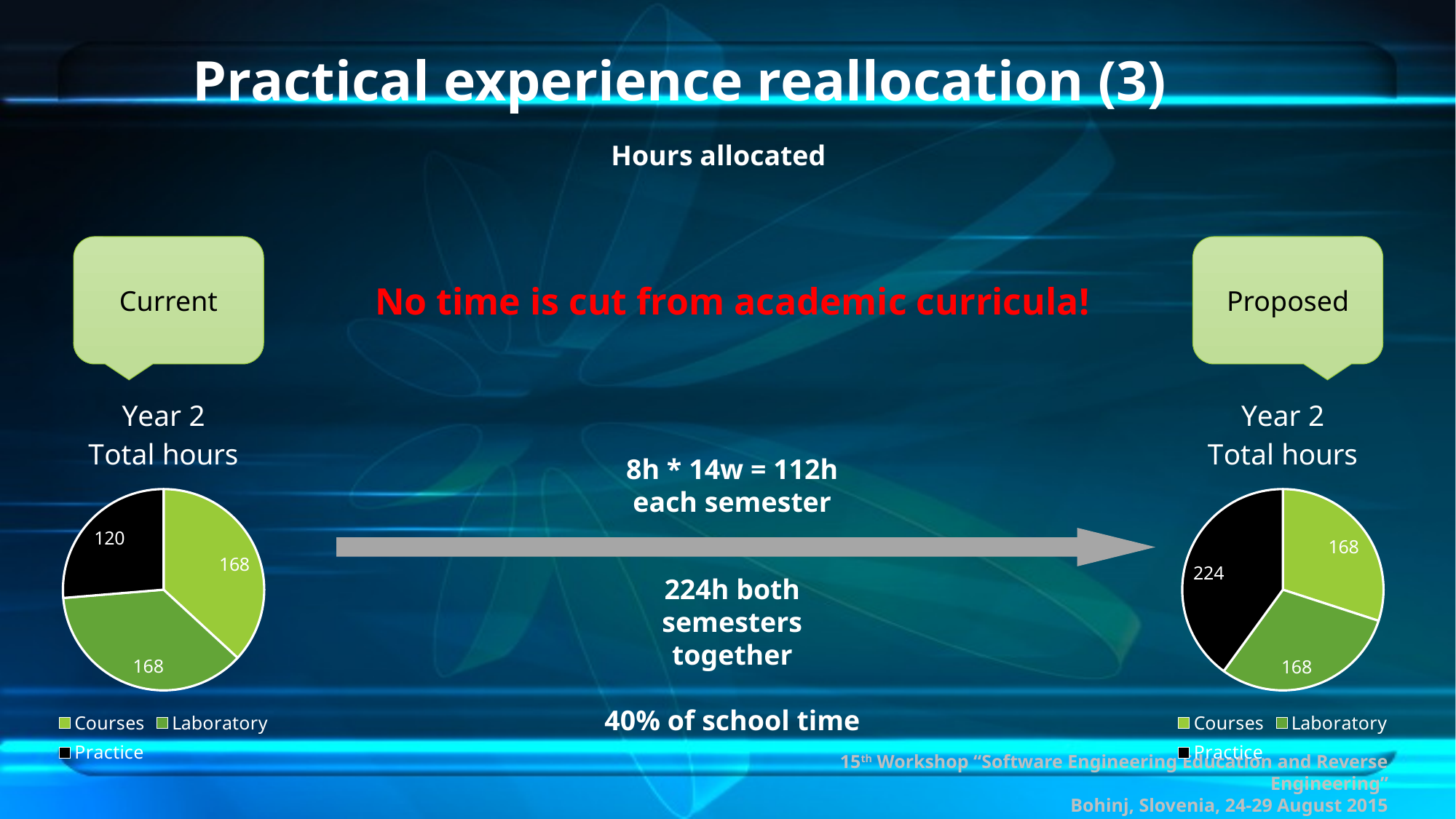
In the Current (left) pie chart, which category has the lowest value? Practice In the Proposed (right) pie chart, what share of the total does Practice represent? 40% What is the difference between the Practice value in the Proposed chart and the Practice value in the Current chart? 104 In the Current (left) pie chart, what is the value for Practice? 120 What type of chart is used for the Current Year 2 Total hours? pie chart In the Proposed (right) pie chart, which category has the highest value? Practice What colour is the Practice slice in both pie charts? black In the Proposed (right) pie chart, what is the value for Courses? 168 In the Current (left) pie chart, is the value for Practice larger or smaller than the value for Laboratory? smaller How many entries does the legend of the Current (left) pie chart list? 3 In the Proposed (right) pie chart, what is the value for Practice? 224 How many slices does the Proposed (right) pie chart have? 3